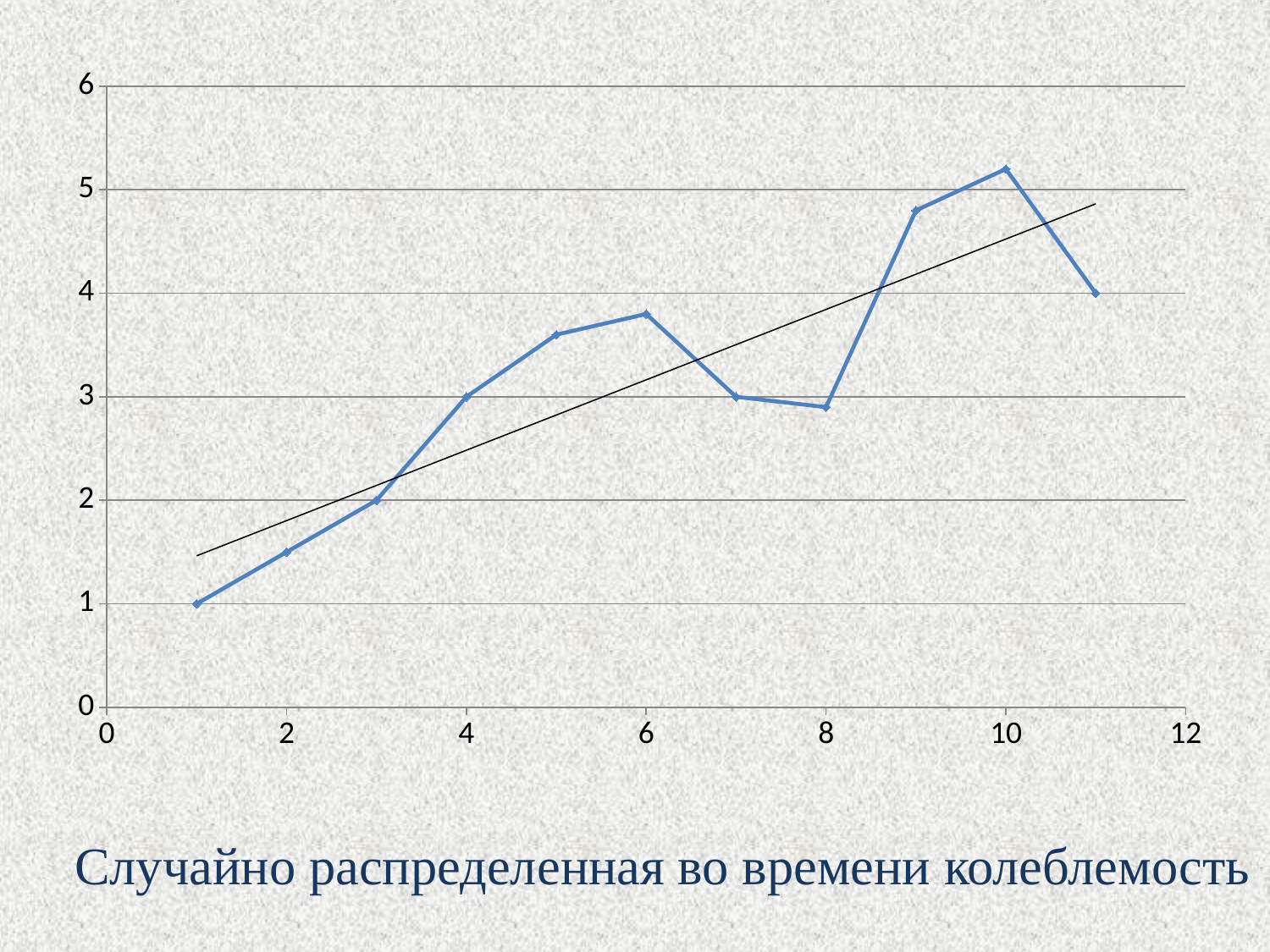
What is the value of the blue line at x = 11? 4 Is the value of the blue line at x = 10 greater or less than 5? greater Which is larger: the value at x = 9 or the value at x = 7? x = 9 What is the value of the blue line at x = 1? 1 At which x value does the blue line reach its highest point? 10 What kind of chart is shown on the slide? line chart How many data points are plotted on the blue line? 11 What is the value of the blue line at x = 4? 3 Is the value of the blue line at x = 6 greater or less than 4? less At which x value does the blue line have its lowest point? 1 Is the value of the blue line at x = 8 greater or less than 3? less What is the value of the blue line at x = 3? 2